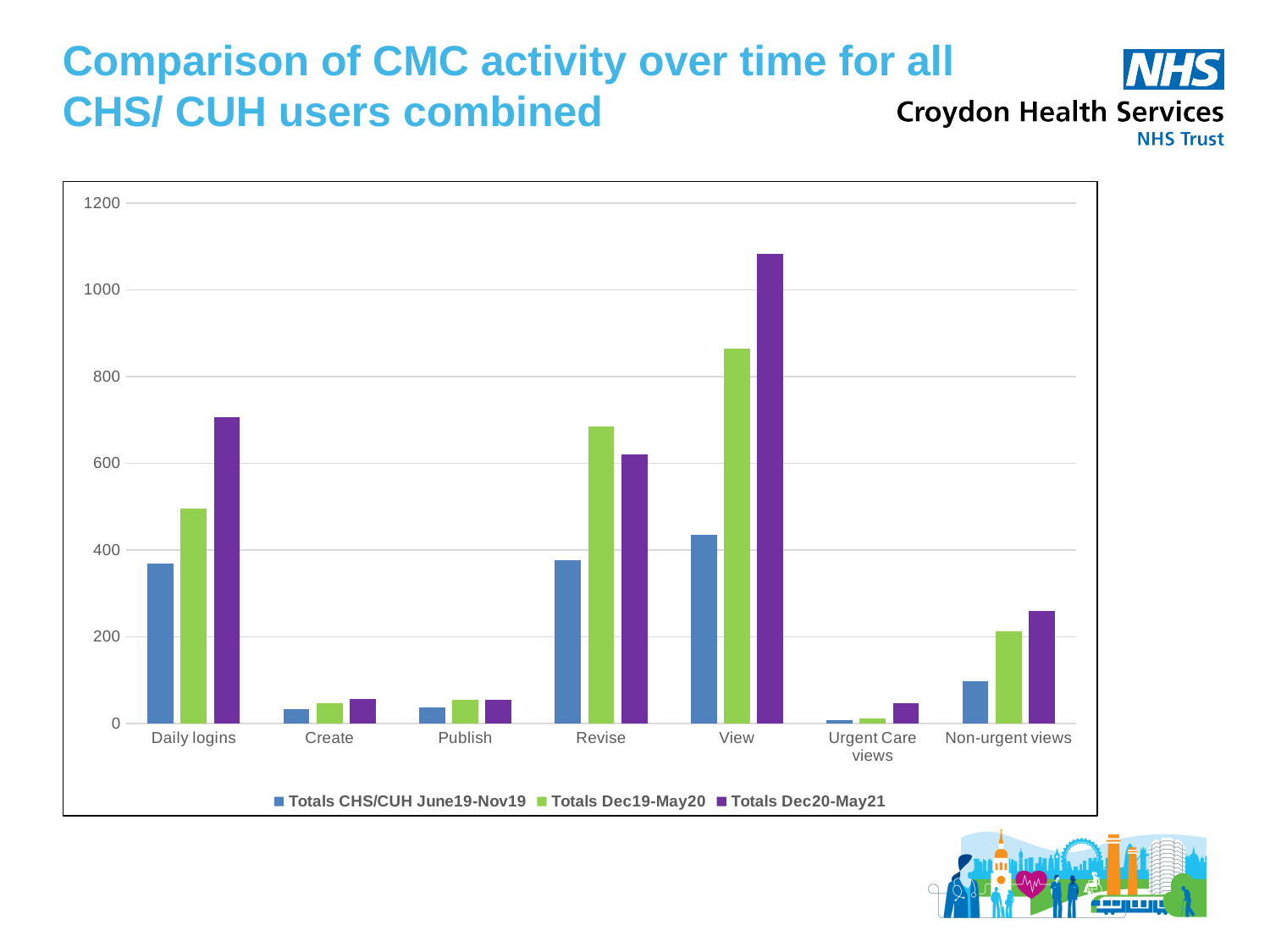
How many series does the legend list? 3 Is the value for View in Totals Dec19-May20 greater or less than 800? greater Is the value for View in Totals Dec20-May21 greater or less than 1000? greater Which category has the highest value for Totals Dec20-May21? View Do the Daily logins values rise or fall across the three periods from June19-Nov19 to Dec20-May21? rise What kind of chart is shown on the slide? Bar chart For Revise, which is larger: Totals Dec19-May20 or Totals Dec20-May21? Totals Dec19-May20 Is the value for Revise in Totals CHS/CUH June19-Nov19 greater or less than 400? less What colour represents the Totals Dec20-May21 series in the legend? Purple Which category has the lowest value for Totals CHS/CUH June19-Nov19? Urgent Care views How many activity categories are shown on the x axis? 7